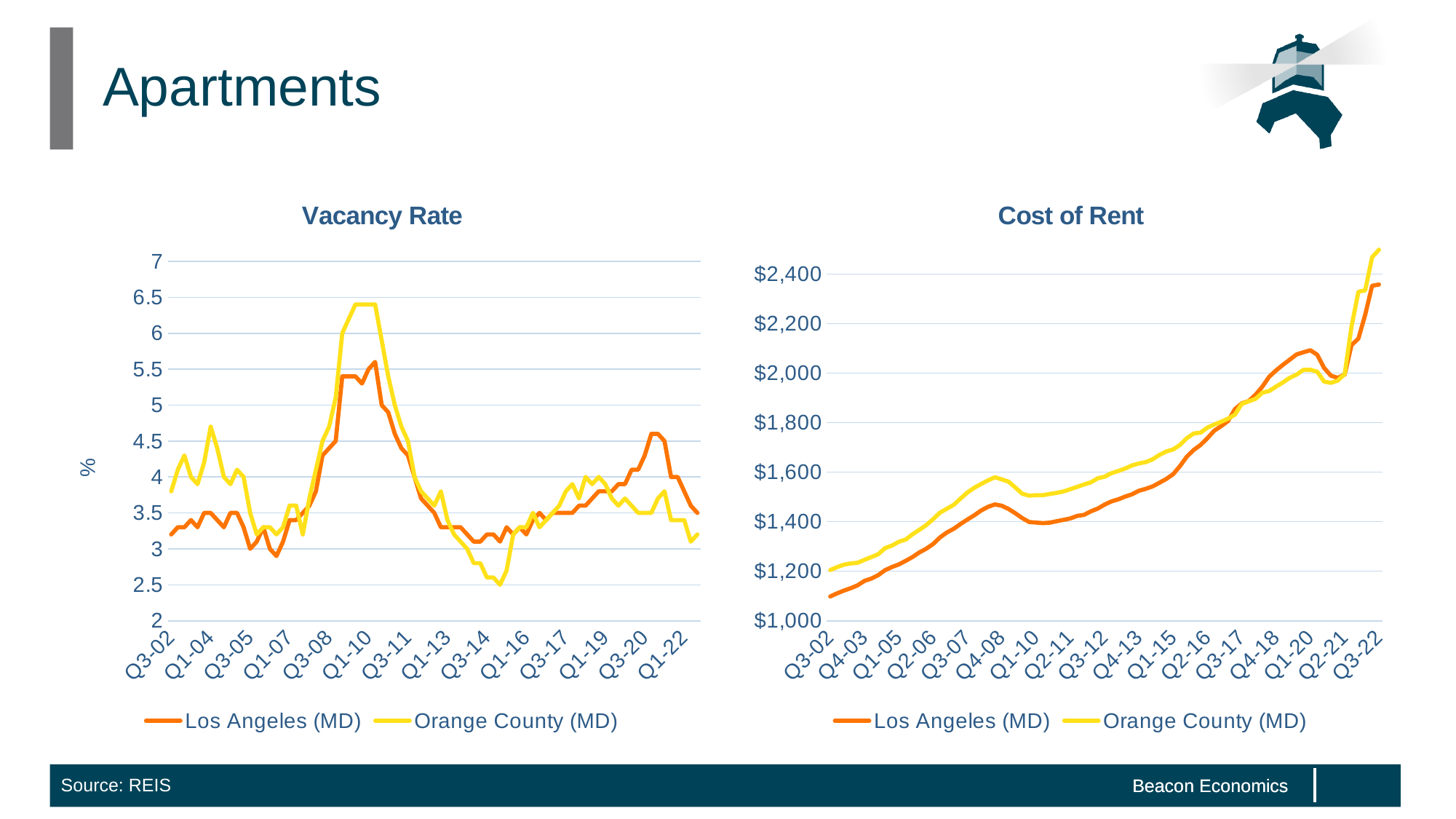
In the Vacancy Rate chart, which series has the higher value at Q1-10? Orange County (MD) Which two series are shown in the legend of the Cost of Rent chart? Los Angeles (MD) and Orange County (MD) In the Cost of Rent chart, which series has the higher value at Q3-02? Orange County (MD) In the Vacancy Rate chart, is the Los Angeles (MD) value at Q1-10 greater or less than 6? less What kind of chart is the Cost of Rent chart? line chart In the Cost of Rent chart, is the Orange County (MD) value at Q3-22 greater or less than $2,400? greater What is the label on the vertical axis of the Vacancy Rate chart? % What kind of chart is the Vacancy Rate chart? line chart In the Vacancy Rate chart, is the Orange County (MD) value at Q1-10 greater or less than 6? greater In the Vacancy Rate chart, which series has the higher value at Q3-20? Los Angeles (MD) How many series does the legend of the Vacancy Rate chart list? 2 In the Cost of Rent chart, do the Los Angeles (MD) values generally rise or fall from Q3-02 to Q3-22? rise